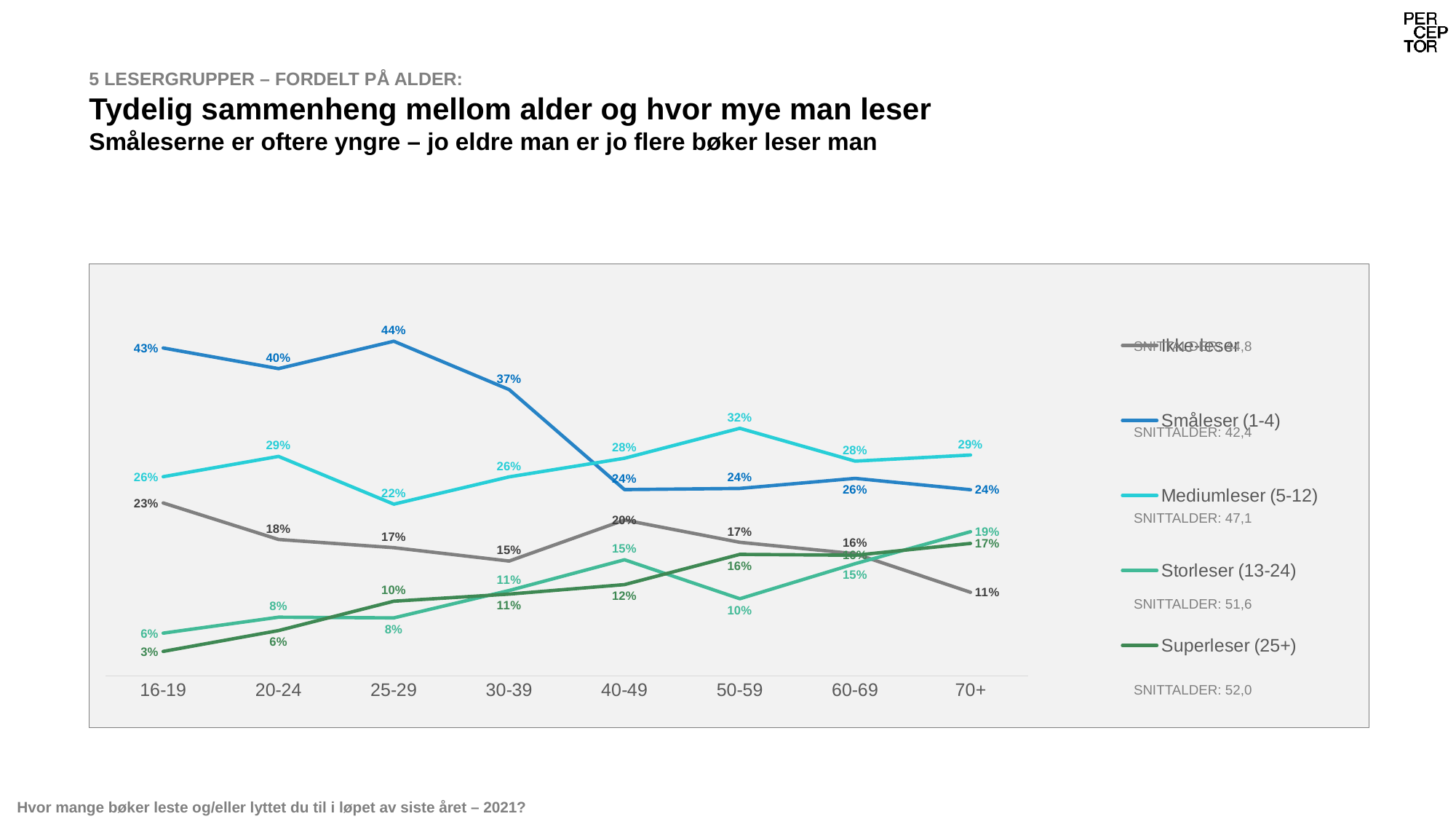
How many series does the chart's legend list? 5 In which age group is the Småleser (1-4) share highest? 25-29 What is the value for Ikke-leser in the 70+ age group? 11% In which age group is the Superleser (25+) share lowest? 16-19 In the 40-49 age group, which is larger: Mediumleser (5-12) or Småleser (1-4)? Mediumleser (5-12) What is the difference between the Småleser (1-4) value for 16-19 and for 70+? 19 percentage points What average age (snittalder) does the legend give for Storleser (13-24)? 51,6 What kind of chart is shown on the slide? Line chart Does the Superleser (25+) line generally rise or fall from 16-19 to 70+? Rise What is the value for Småleser (1-4) in the 25-29 age group? 44% How many age groups are shown on the x axis of the chart? 8 What is the value for Mediumleser (5-12) in the 50-59 age group? 32%